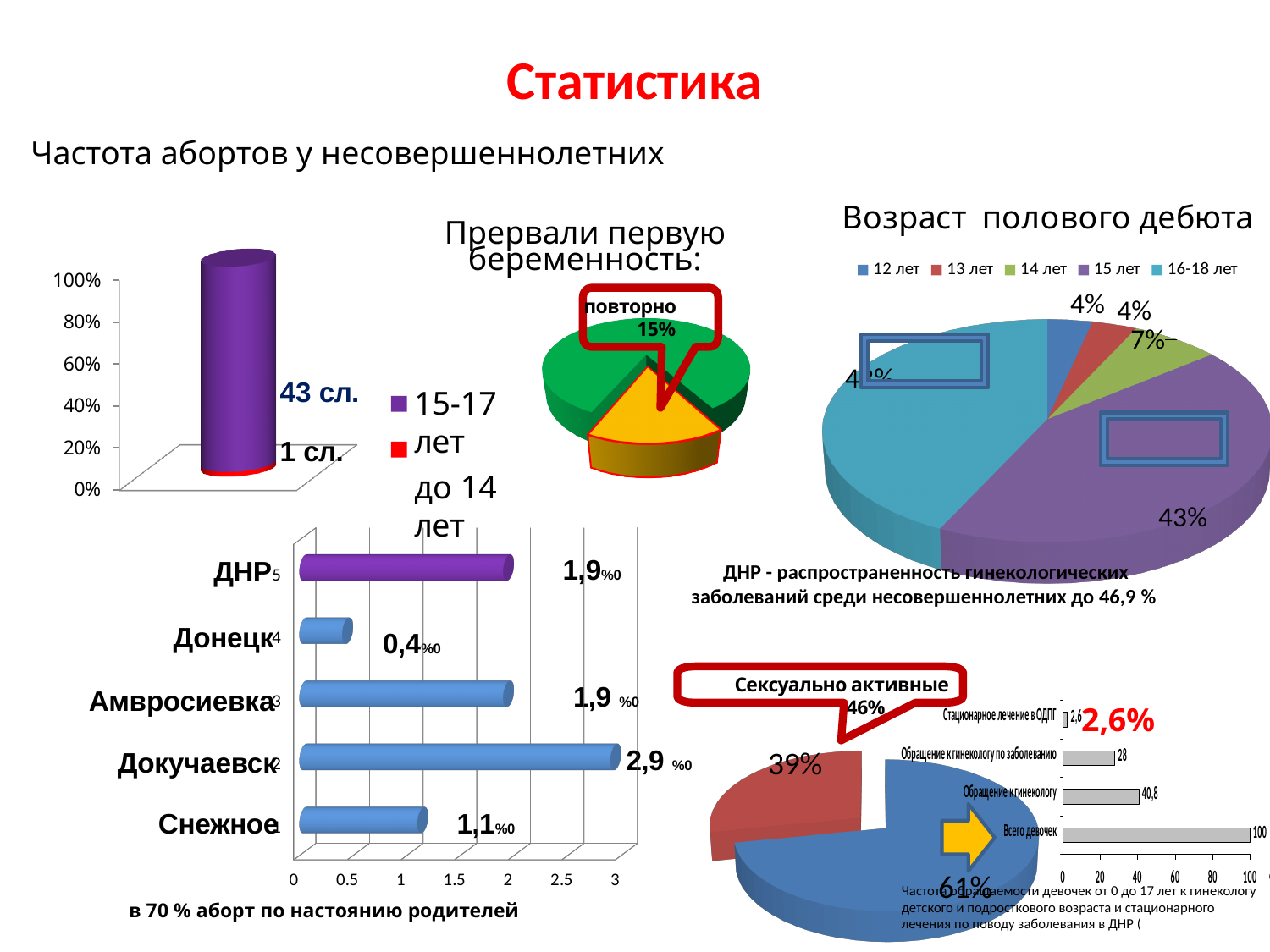
In the horizontal bar chart at the bottom left, what is the value for Докучаевск? 2,9 In the bar chart at the bottom right, what is the value for 'Обращение к гинекологу'? 40,8 In the pie chart titled 'Возраст полового дебюта', what share is shown for the 15 лет slice? 43% How many series does the legend of the pie chart 'Возраст полового дебюта' list? 5 In the horizontal bar chart at the bottom left, what is the value for Донецк? 0,4 In the horizontal bar chart at the bottom left, which category has the highest value? Докучаевск In the bar chart at the bottom right, what is the value for 'Стационарное лечение в ОДПГ'? 2,6 In the horizontal bar chart at the bottom left, which category has the lowest value? Донецк In the pie chart 'Сексуально активные' at the bottom, which slice is larger, the one labelled 39% or the one labelled 61%? 61% In the horizontal bar chart at the bottom left, what is the difference between the values for Докучаевск and Снежное? 1,8 In the horizontal bar chart at the bottom left, how many categories are shown? 5 What kind of chart is the one at the bottom right showing 'Всего девочек'? Bar chart